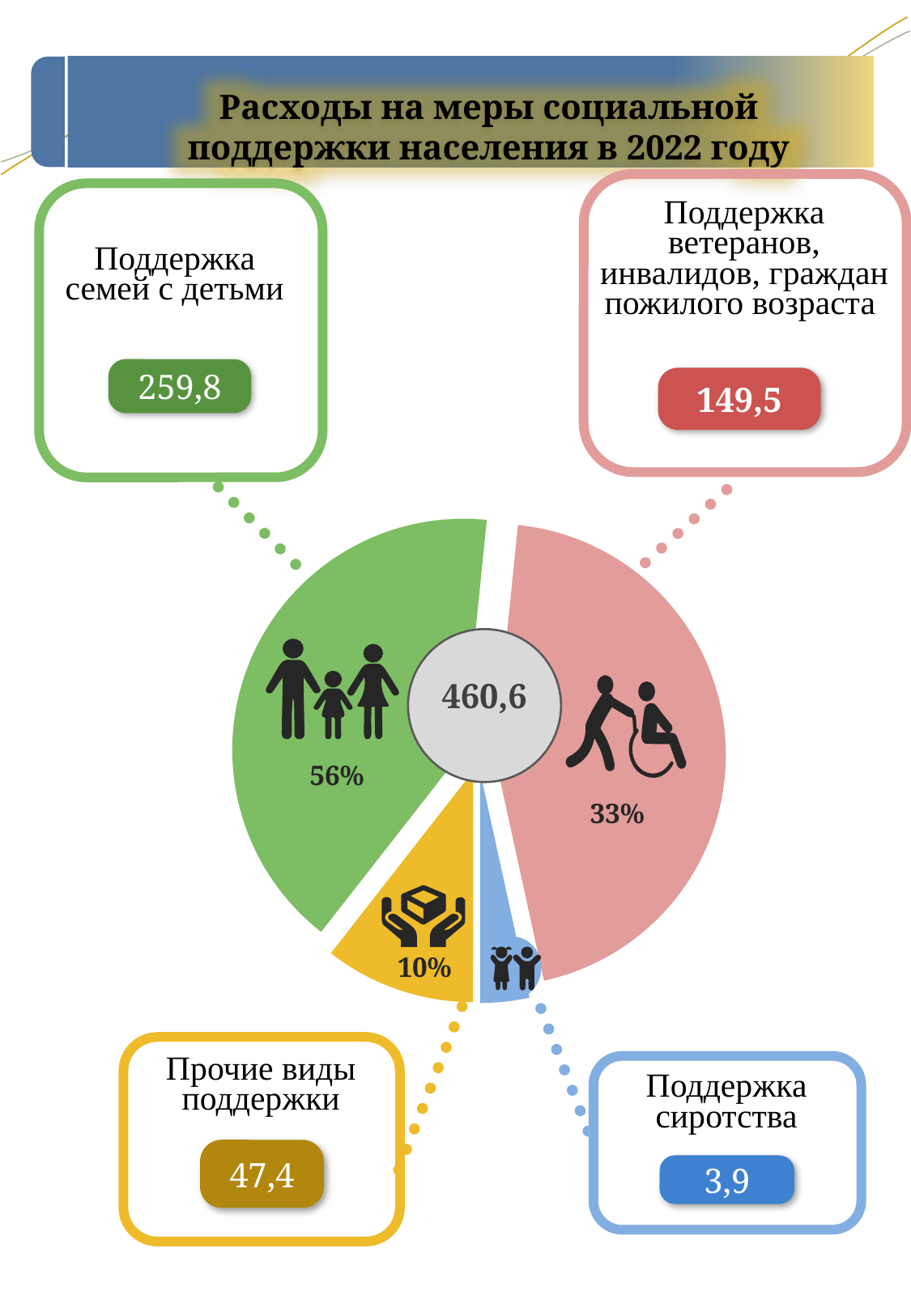
What share of the pie does Поддержка ветеранов, инвалидов, граждан пожилого возраста take? 33% Which category has the smallest slice of the pie? Поддержка сиротства What is the value for Поддержка семей с детьми? 259,8 What type of chart is shown on the slide? pie chart What share of the pie does Поддержка семей с детьми take? 56% What is the value for Поддержка сиротства? 3,9 Which category has the largest slice of the pie? Поддержка семей с детьми What is the value for Поддержка ветеранов, инвалидов, граждан пожилого возраста? 149,5 How many slices does the pie chart have? 4 What is the value for Прочие виды поддержки? 47,4 What is the difference between the values for Поддержка семей с детьми and Поддержка ветеранов, инвалидов, граждан пожилого возраста? 110,3 What total value is shown in the centre of the pie chart? 460,6